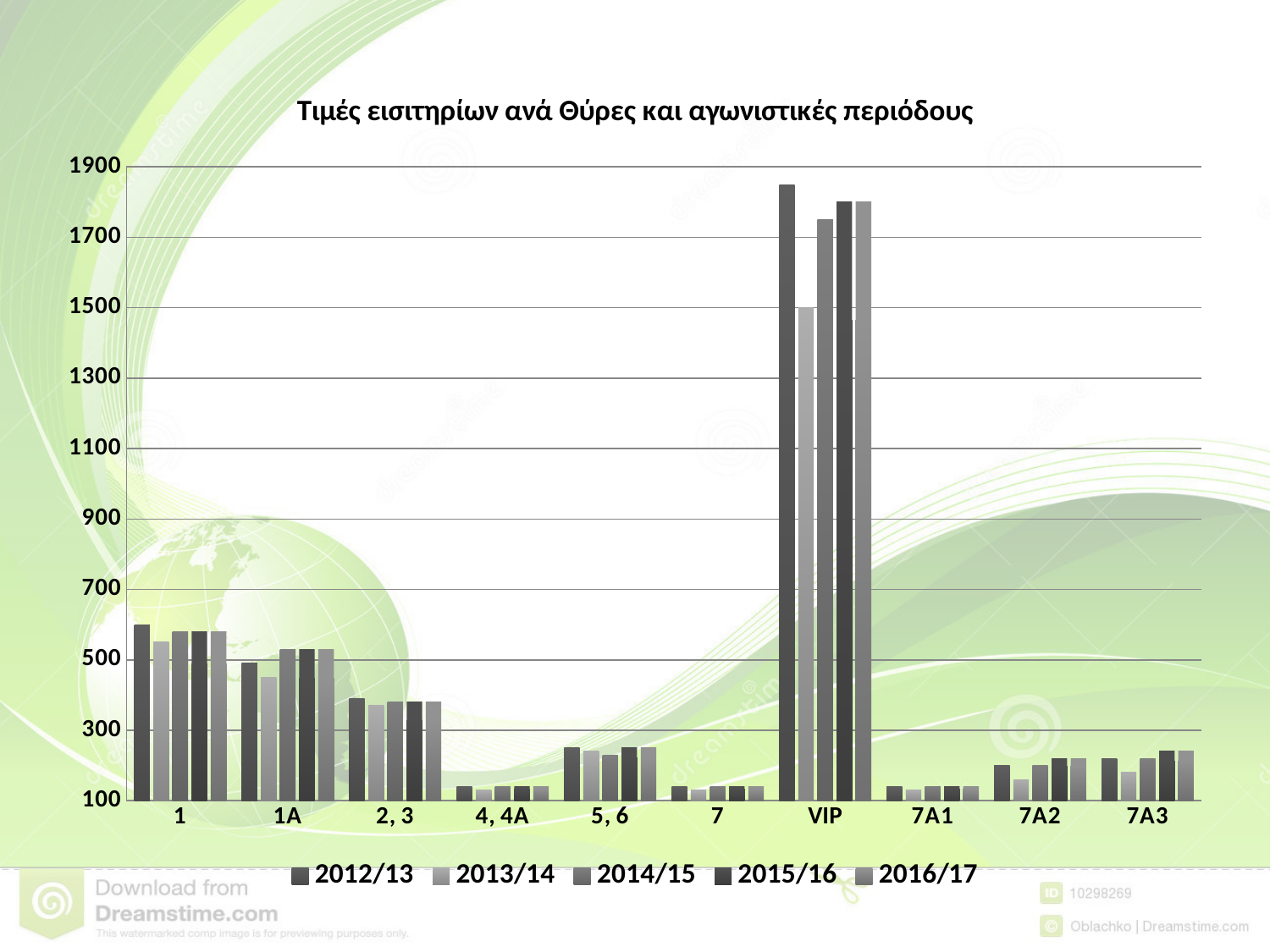
Is the value for VIP in 2013/14 greater or less than 1300? greater How many categories are shown on the x axis of the chart? 10 Which category has the highest bars in the chart? VIP How many series does the legend list? 5 What is the first series listed in the legend? 2012/13 What kind of chart is shown on the slide? bar chart For VIP, which season has the larger value: 2012/13 or 2013/14? 2012/13 For 2016/17, which category has the larger value: 2, 3 or 5, 6? 2, 3 Is the value for category 4, 4A in 2012/13 greater or less than 300? less Is the value for VIP in 2012/13 greater or less than 1700? greater For 2012/13, which category has the larger value: 1 or 1A? 1